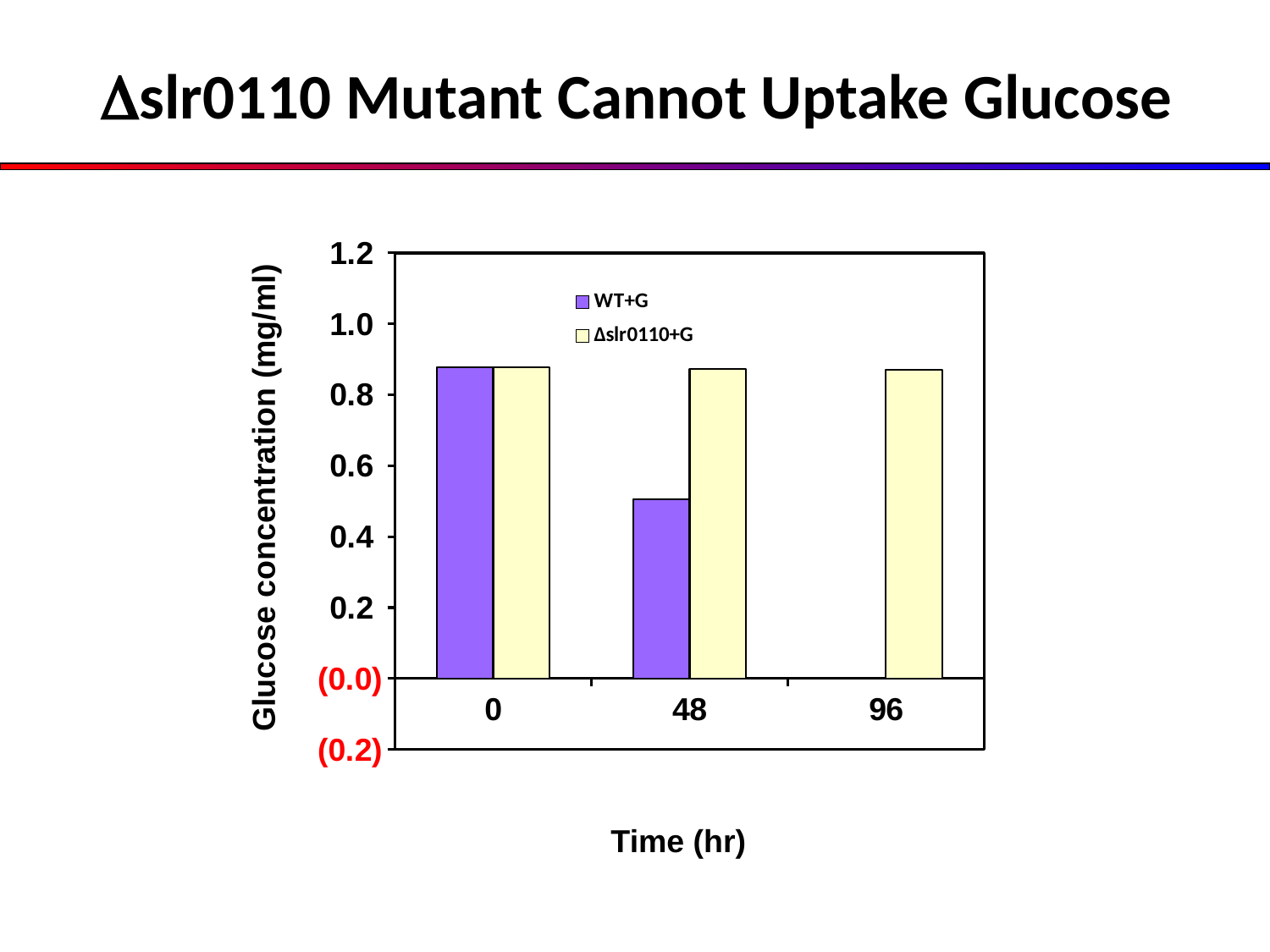
Is the value for WT+G at 0 hr greater or less than 0.8? greater How many series does the legend list? 2 Is the value for Δslr0110+G at 96 hr greater or less than 0.8? greater At 48 hr, which series has the larger value, WT+G or Δslr0110+G? Δslr0110+G What is the label of the y axis? Glucose concentration (mg/ml) Do the WT+G values rise or fall as time increases? fall What kind of chart is shown on the slide? bar chart Is the value for WT+G at 48 hr greater or less than 0.6? less Which series is shown in purple? WT+G At which time point is the WT+G value lowest? 96 How many time points are shown on the x axis? 3